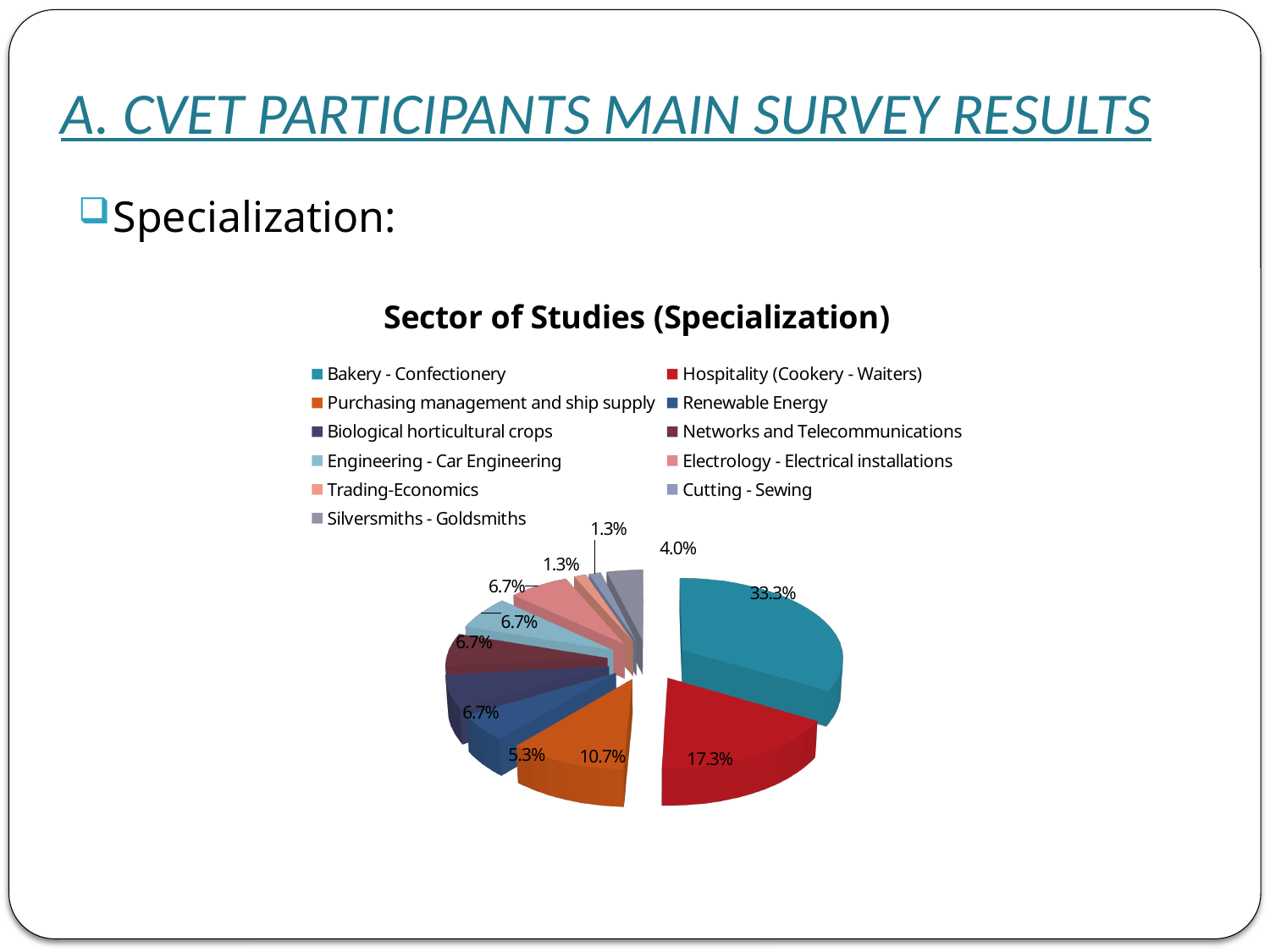
What kind of chart is shown on the slide? pie chart What share of the pie is Hospitality (Cookery - Waiters)? 17.3% What share of the pie is Engineering - Car Engineering? 6.7% What share of the pie is Silversmiths - Goldsmiths? 4.0% What is the difference in percentage points between Bakery - Confectionery and Hospitality (Cookery - Waiters)? 16.0 How many sectors does the legend list? 11 What share of the pie is Trading-Economics? 1.3% Which has the larger share: Purchasing management and ship supply or Silversmiths - Goldsmiths? Purchasing management and ship supply What share of the pie is Purchasing management and ship supply? 10.7% What share of the pie is Bakery - Confectionery? 33.3% Which sector has the largest share of the pie? Bakery - Confectionery What is the title of the chart? Sector of Studies (Specialization)